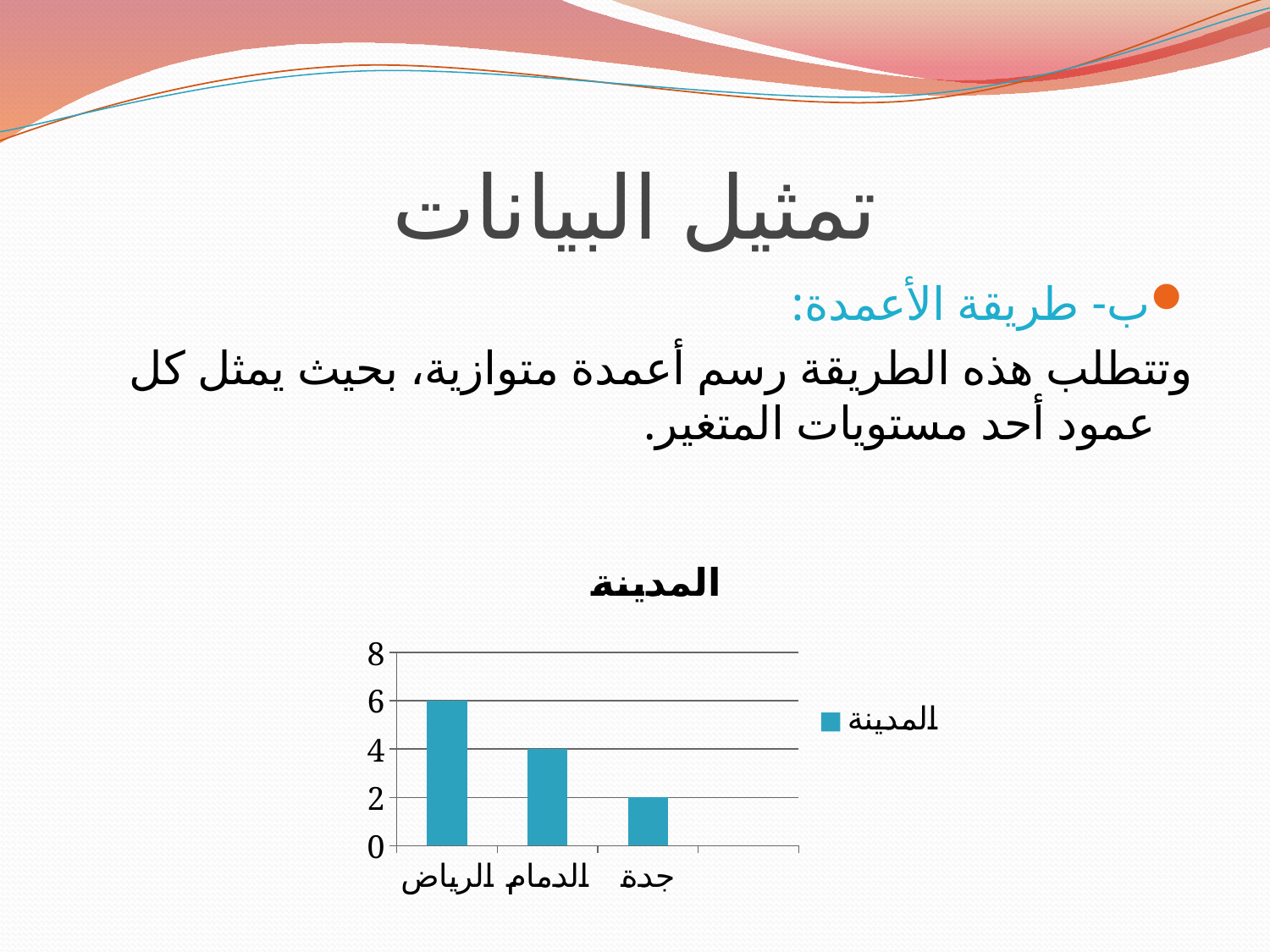
Which category has the lowest value? جدة What is the value for الدمام? 4 What is the value for جدة? 2 What is the difference between the values for الرياض and جدة? 4 How many categories are shown on the x axis of the chart? 3 Which category has the highest value? الرياض What is the value for الرياض? 6 Do the values rise or fall moving from الرياض to جدة along the x axis? fall Which is larger, the value for الدمام or the value for جدة? الدمام How many series does the chart's legend list? 1 What kind of chart is shown on the slide? bar chart What is the title of the chart? المدينة